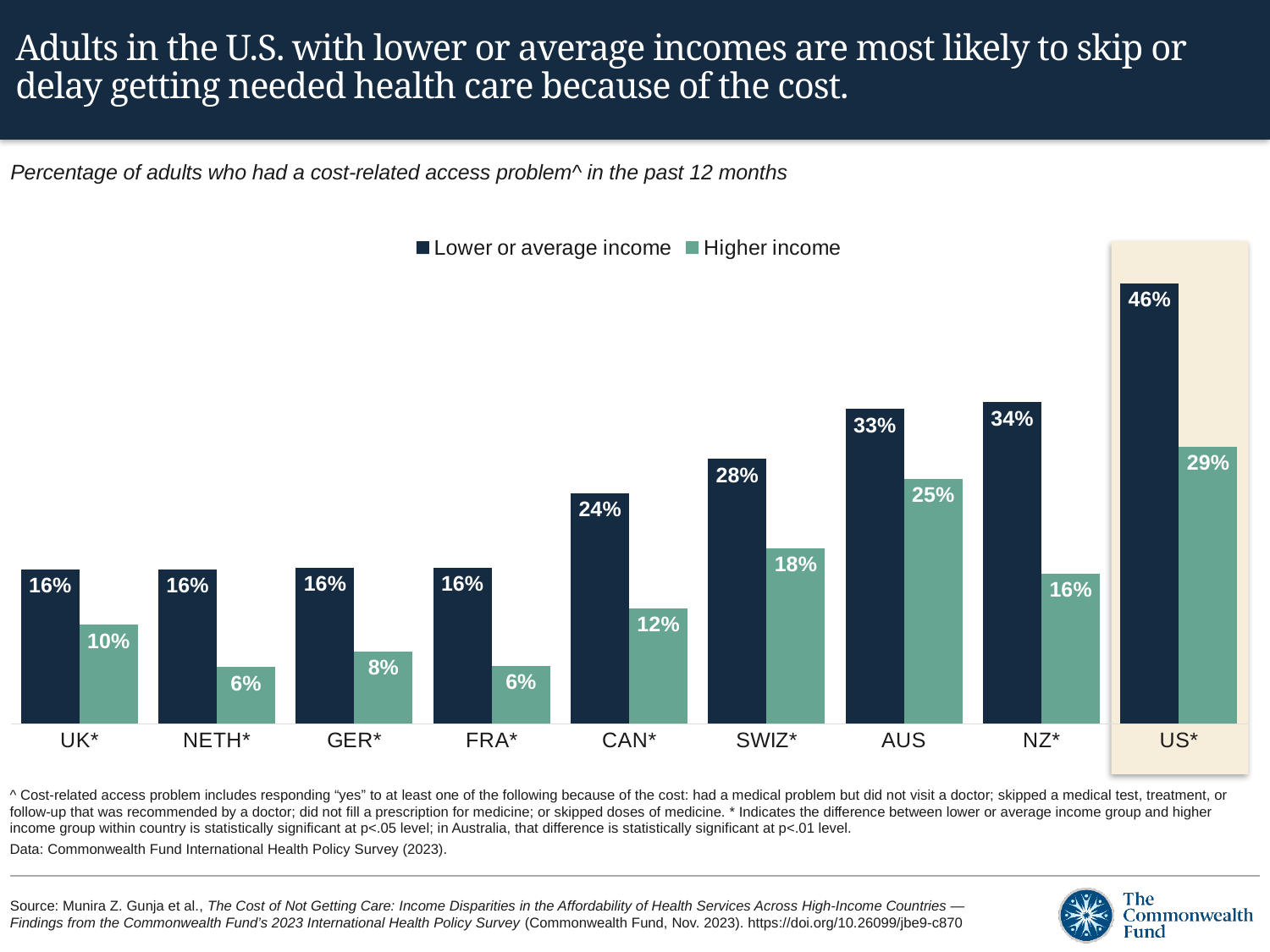
How many countries are shown on the x axis? 9 What is the difference between the Lower or average income and Higher income values for US*? 17 percentage points What is the value for the Higher income series for NETH*? 6% Which is larger: the Lower or average income value for NZ* or for AUS? NZ* Which country has the lowest value for the Higher income series? NETH* and FRA* (both 6%) Which series is shown in dark navy bars? Lower or average income What kind of chart is shown on the slide? Bar chart What is the value for the Higher income series for AUS? 25% How many series does the legend list? 2 Do the Lower or average income values generally rise or fall from left to right along the x axis? Rise What is the value for the Lower or average income series for US*? 46% Which country has the highest value for the Higher income series? US*